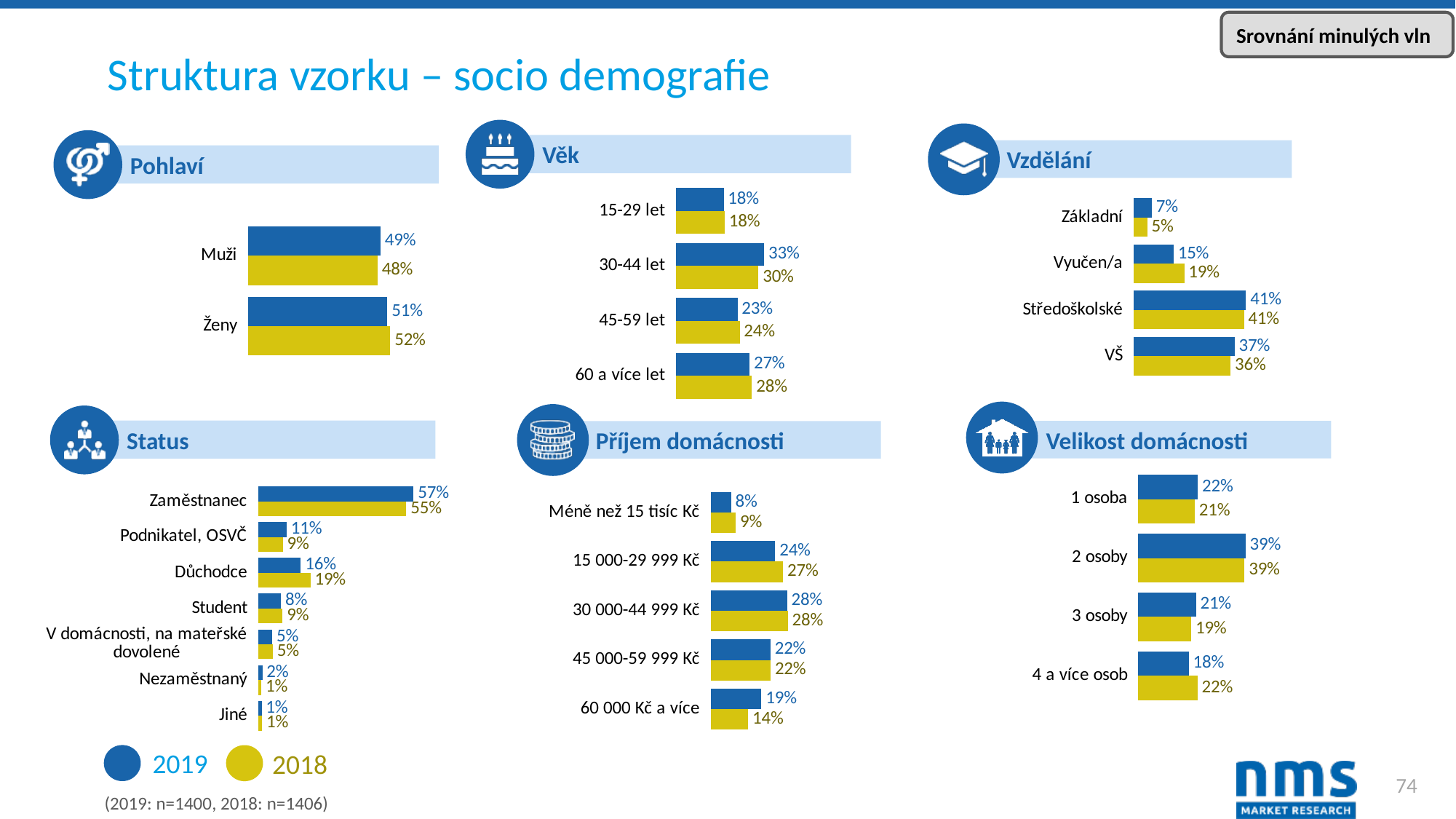
In the Velikost domácnosti chart, which is larger for 4 a více osob: the 2019 value or the 2018 value? 2018 In the Příjem domácnosti chart, which category has the highest 2019 value? 30 000-44 999 Kč How many categories does the Status chart show? 7 In the Pohlaví chart, what is the 2019 value for Muži? 49% In the Vzdělání chart, which category has the highest 2019 value? Středoškolské In the Věk chart, what is the 2018 value for 30-44 let? 30% In the Vzdělání chart, what is the 2018 value for Vyučen/a? 19% In the Status chart, which category has the lowest 2019 value? Jiné How many series does the legend list? 2 What kind of chart is the Věk chart? bar chart Which colour represents the 2018 series in the legend? yellow In the Příjem domácnosti chart, what is the difference between the 2019 and 2018 values for 60 000 Kč a více? 5%